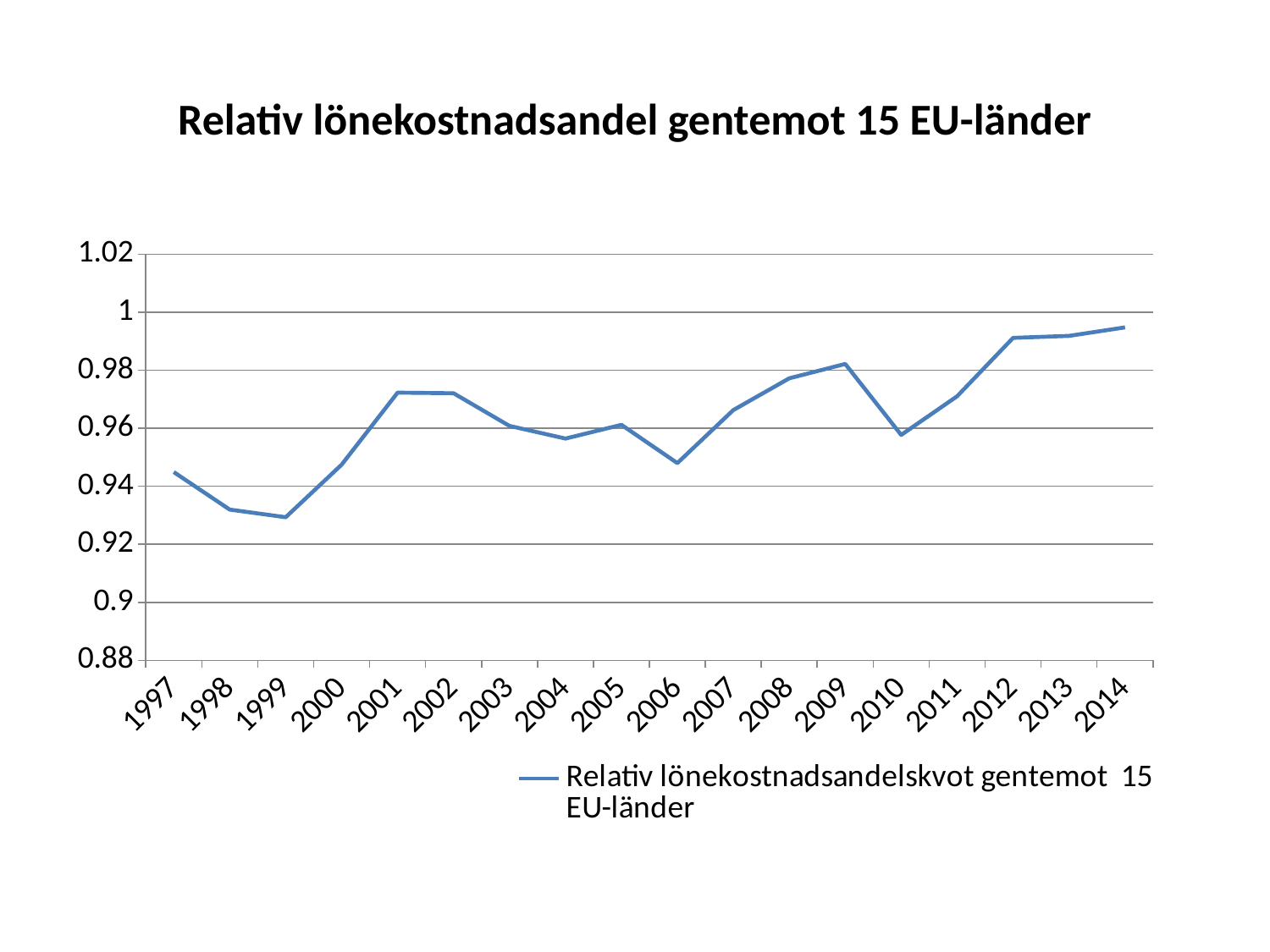
Is the value for 2001 greater or less than 0.96? greater What kind of chart is shown on the slide? line chart Which year has the highest value? 2014 Overall, does the value rise or fall from 1997 to 2014? rise Is the value for 2006 greater or less than 0.96? less Is the value for 2012 greater or less than 0.98? greater How many years are plotted along the x axis? 18 Which is larger, the value for 1997 or the value for 2014? 2014 How many series does the legend list? 1 Which is larger, the value for 2009 or the value for 2010? 2009 What is the title of the chart? Relativ lönekostnadsandel gentemot 15 EU-länder